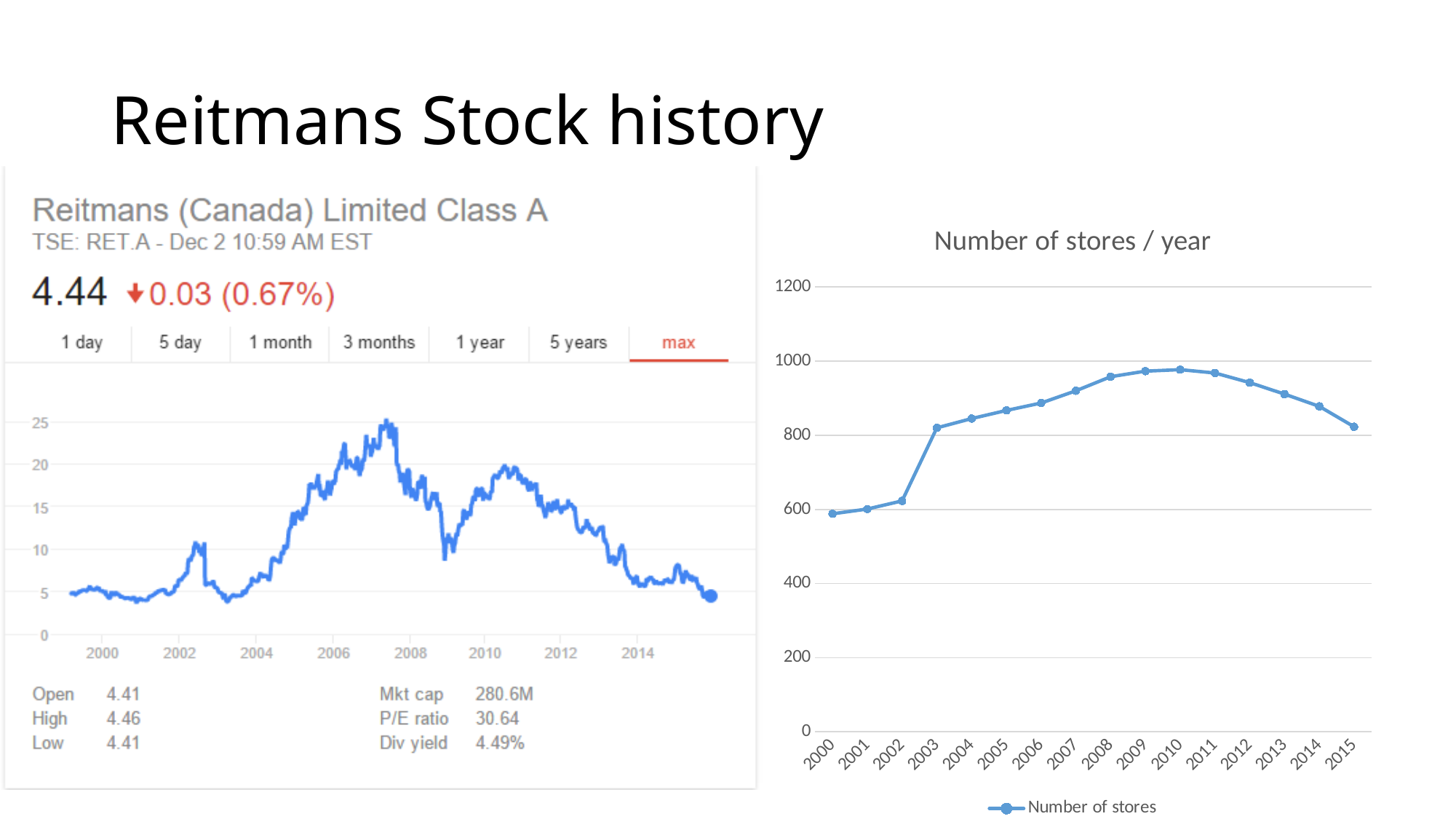
In the 'Number of stores / year' chart, do the values rise or fall from 2010 to 2015? Fall In the 'Number of stores / year' chart, do the values rise or fall from 2000 to 2010? Rise What type of chart is the 'Number of stores / year' chart on the right? Line chart How many series does the legend of the 'Number of stores / year' chart list? 1 In the 'Number of stores / year' chart, is the value for 2003 greater or less than 800? greater What is the legend entry in the 'Number of stores / year' chart? Number of stores In the 'Number of stores / year' chart, is the value for 2010 greater or less than 1000? less In the 'Number of stores / year' chart, which year has the larger number of stores, 2010 or 2015? 2010 In the stock price chart on the left, is the peak value around 2007 greater or less than 20? greater In the 'Number of stores / year' chart, how many years are shown on the x axis? 16 In the 'Number of stores / year' chart, which year has the larger number of stores, 2002 or 2003? 2003